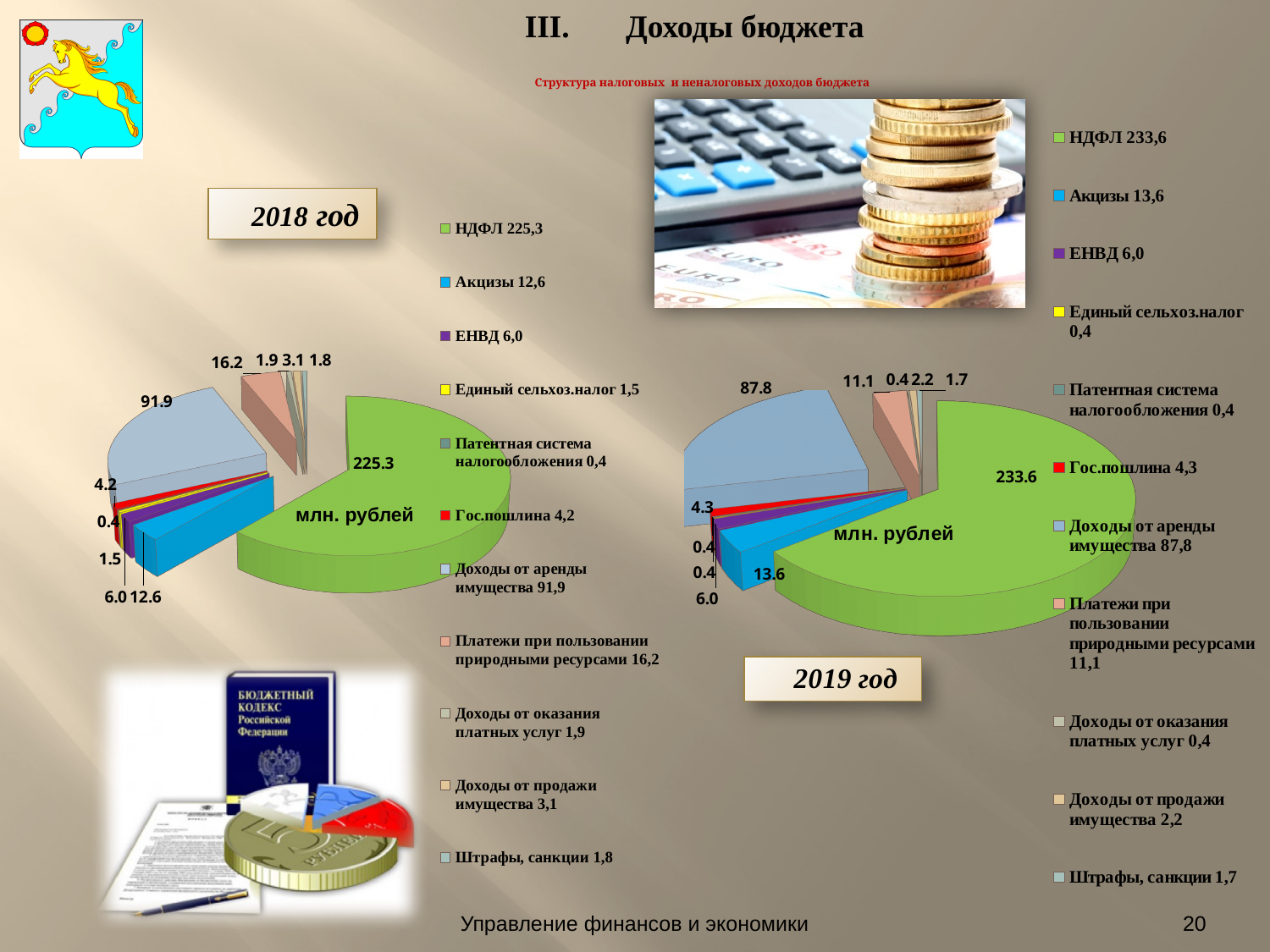
On the 2019 год pie chart, what is the value for Доходы от аренды имущества? 87.8 On the 2018 год pie chart, what is the value for НДФЛ? 225.3 What is the difference between the НДФЛ value on the 2019 год chart and the НДФЛ value on the 2018 год chart? 8.3 On the 2018 год pie chart, which category has the smallest value? Патентная система налогообложения What unit is printed in the centre of both pie charts? млн. рублей On the 2019 год pie chart, what is the value for Акцизы? 13.6 On the 2019 год pie chart, which category has the largest value? НДФЛ What type of chart is used to show the 2019 год data? Pie chart On the 2018 год pie chart, what is the value for Платежи при пользовании природными ресурсами? 16.2 How many categories does the 2018 год pie chart show? 11 On the 2019 год pie chart, which is larger: Акцизы or Гос.пошлина? Акцизы On the 2018 год pie chart, what is the difference between Доходы от аренды имущества and Платежи при пользовании природными ресурсами? 75.7